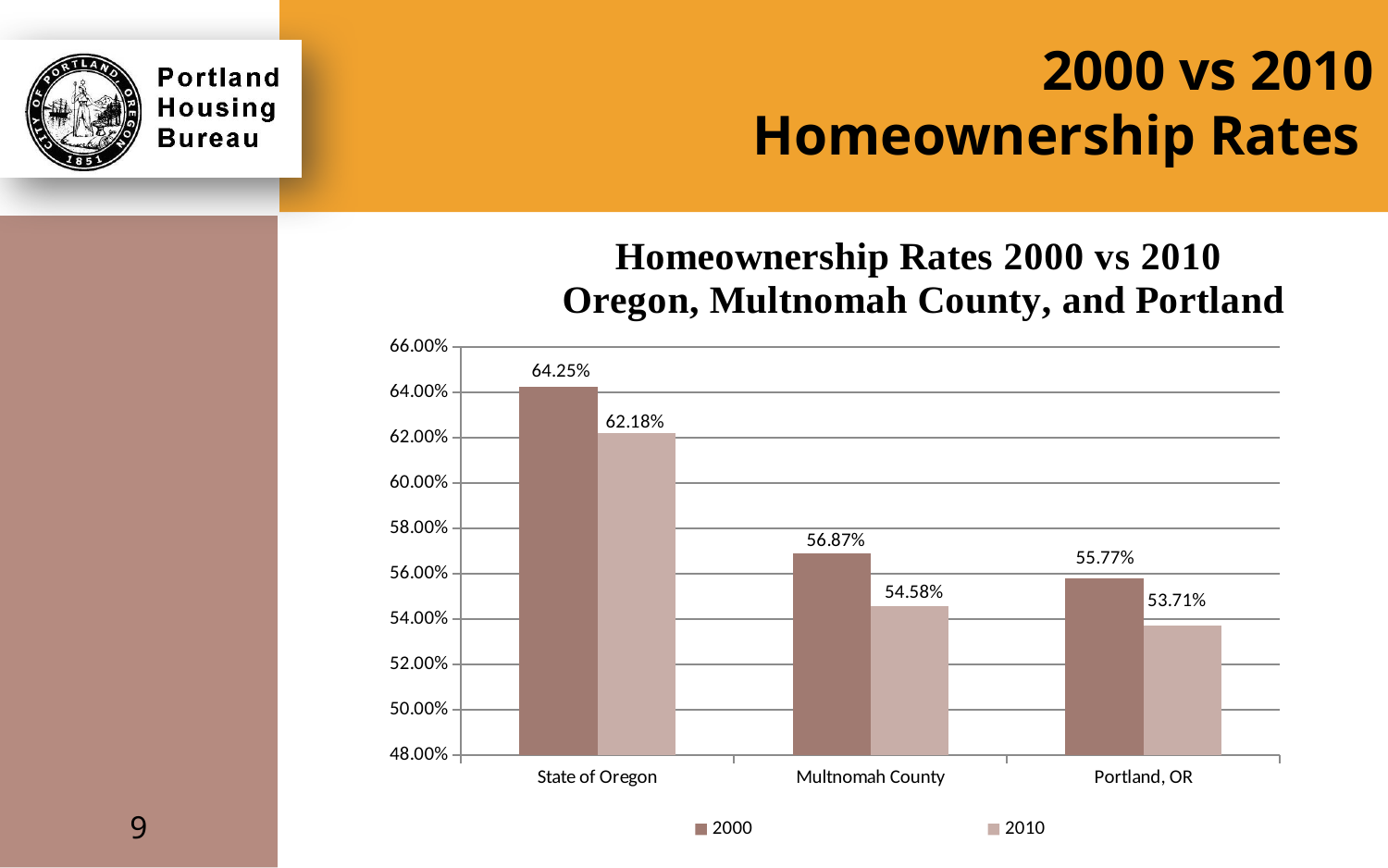
How many series does the legend list? 2 What was the homeownership rate for Portland, OR in 2000? 55.77% Is the 2010 homeownership rate for Portland, OR greater or less than 54.00%? less What was the homeownership rate for Multnomah County in 2010? 54.58% How many geographic categories are shown on the x axis? 3 Which category has the lowest 2010 homeownership rate? Portland, OR Which category has the highest 2010 homeownership rate? State of Oregon What kind of chart is shown on the slide? Bar chart By how many percentage points did the State of Oregon homeownership rate change from 2000 to 2010? 2.07 percentage points What is the difference between the 2000 homeownership rates of Multnomah County and Portland, OR? 1.10 percentage points What was the homeownership rate for the State of Oregon in 2000? 64.25% Which is larger: the 2010 rate for Multnomah County or the 2000 rate for Portland, OR? 2000 rate for Portland, OR